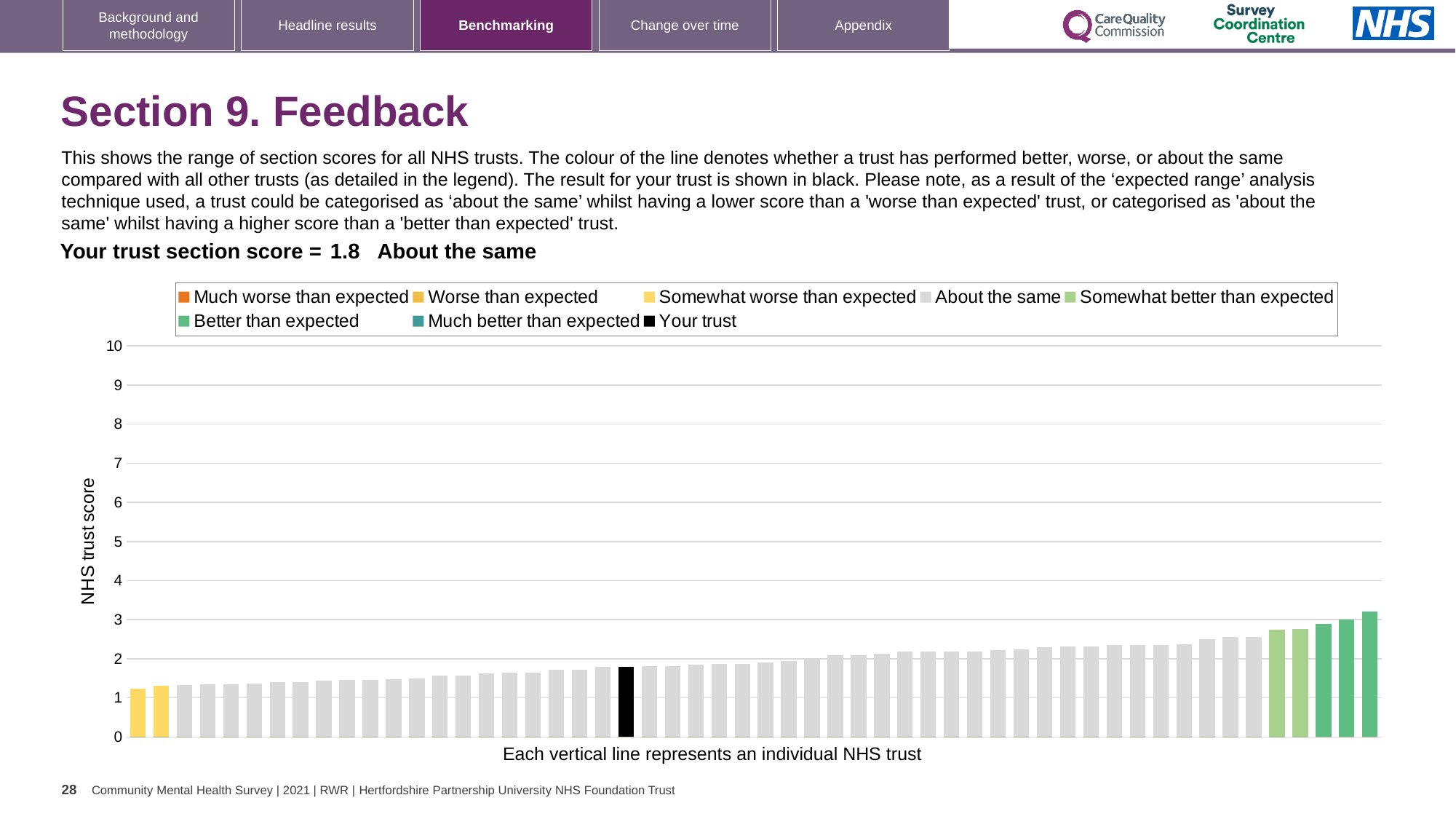
What is the label on the vertical axis of the chart? NHS trust score What is the section score for your trust shown on the slide? 1.8 How many entries does the chart legend list? 8 Which is larger: the value for your trust (black bar) or the value of the rightmost bar? the rightmost bar Is the value of the shortest bar greater or less than 2? less What is the highest value shown on the vertical axis? 10 What colour is the bar representing your trust? black What kind of chart is shown on the slide? bar chart Is the value for your trust (the black bar) greater or less than 2? less Which is larger: the value for your trust (black bar) or the value of the leftmost bar? your trust Do the bar values rise or fall from left to right along the x axis? rise Is the value of the tallest bar greater or less than 4? less